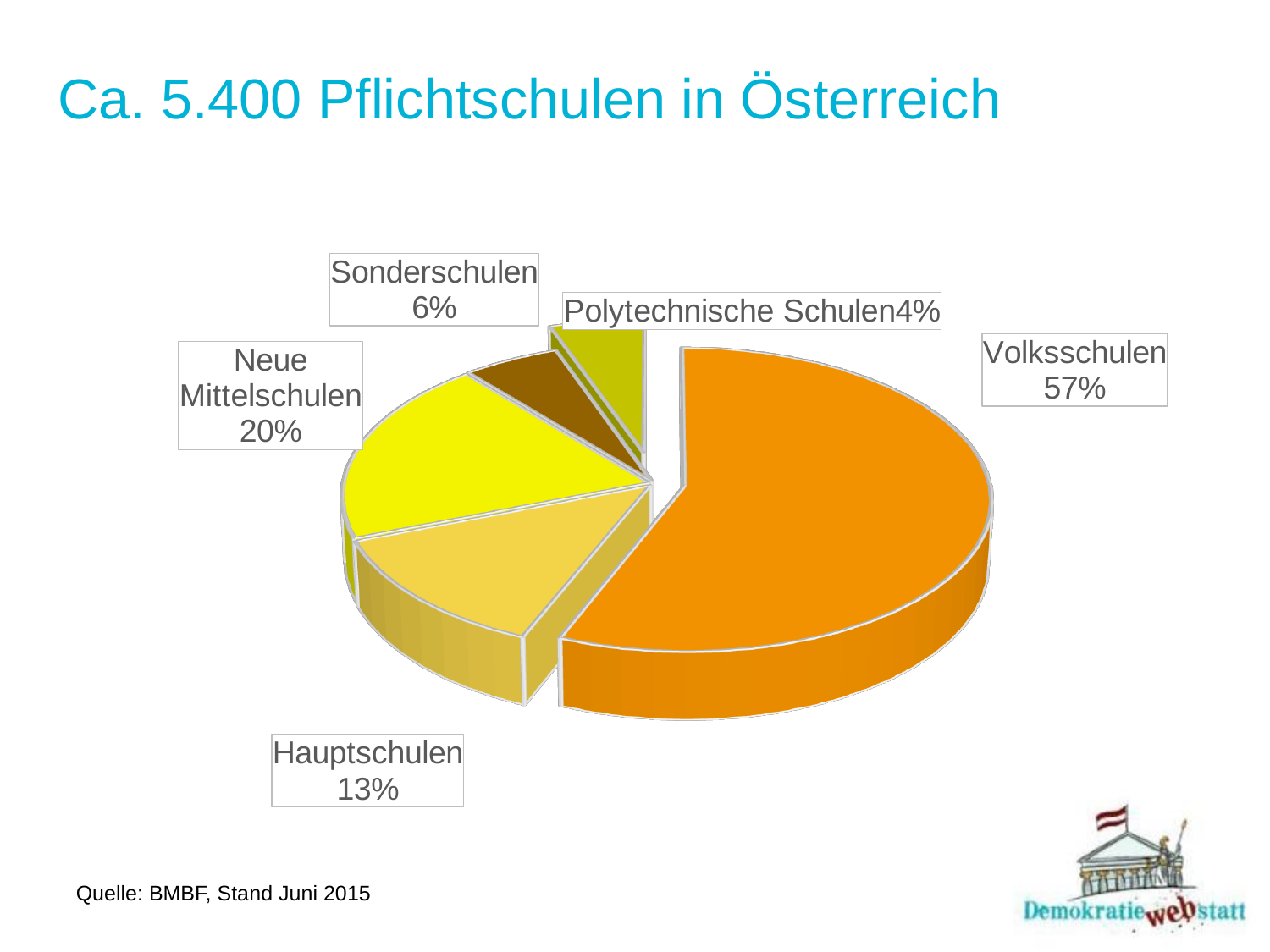
What percentage is shown for Polytechnische Schulen? 4% What share of the pie do Volksschulen make up? 57% Which is larger, the share for Hauptschulen or the share for Sonderschulen? Hauptschulen What percentage is shown for Hauptschulen? 13% What is the difference in percentage points between Volksschulen and Neue Mittelschulen? 37 How many categories are shown in the pie chart? 5 What is the title of the slide? Ca. 5.400 Pflichtschulen in Österreich What kind of chart is shown on the slide? Pie chart What percentage is shown for Neue Mittelschulen? 20% Which category has the largest slice of the pie? Volksschulen What percentage is shown for Sonderschulen? 6% Which category has the smallest slice of the pie? Polytechnische Schulen